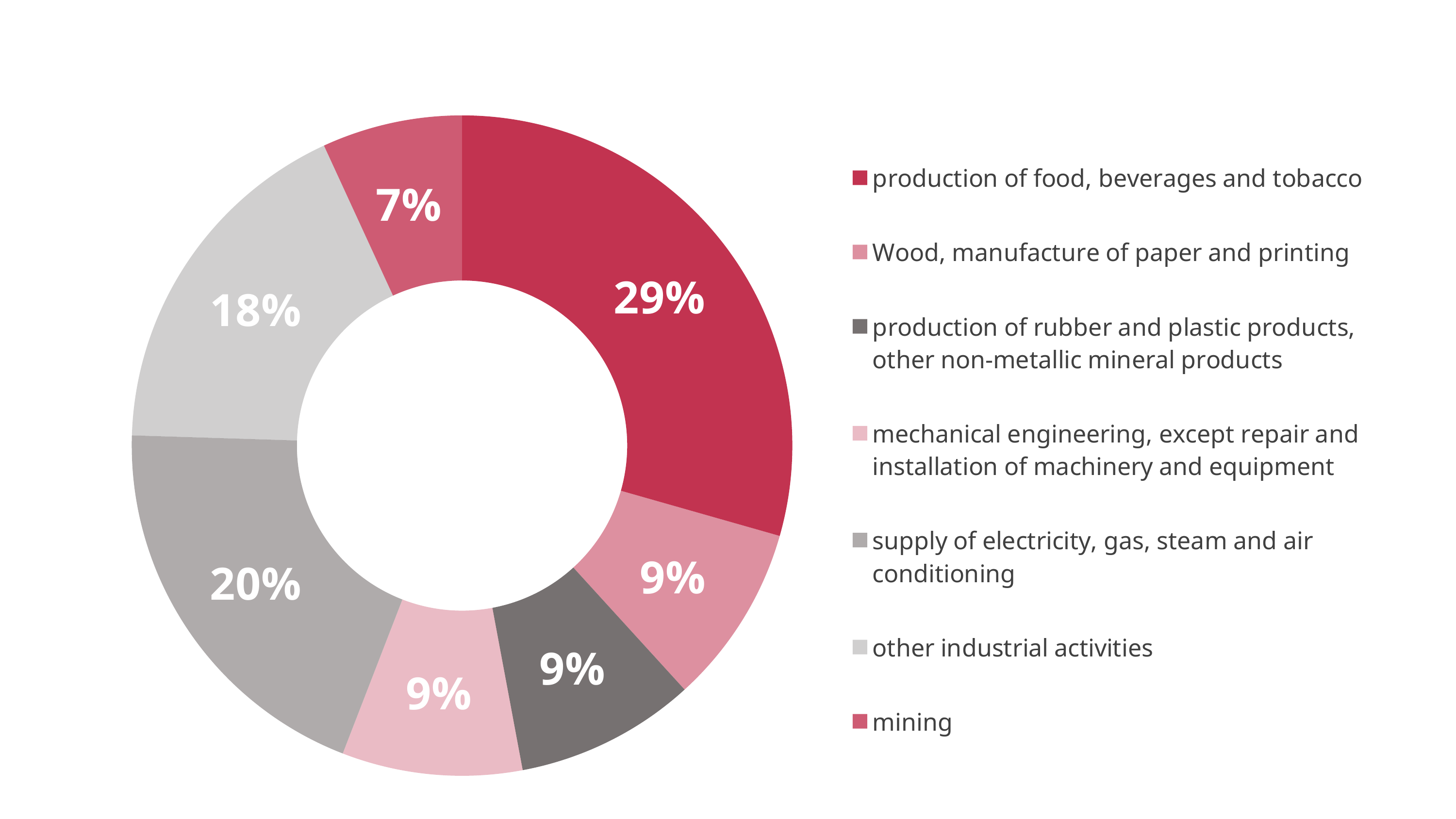
What share does Wood, manufacture of paper and printing have? 9% What share does production of food, beverages and tobacco have? 29% Which category has the smallest share? mining What share does mining have? 7% How many categories have a share of 9%? 3 What is the difference between the share of production of food, beverages and tobacco and the share of supply of electricity, gas, steam and air conditioning? 9% What kind of chart is shown on the slide? Pie chart (donut) Which is larger: the share of other industrial activities or the share of mining? other industrial activities What share does supply of electricity, gas, steam and air conditioning have? 20% How many categories does the chart show? 7 Which category has the largest share? production of food, beverages and tobacco What share does other industrial activities have? 18%